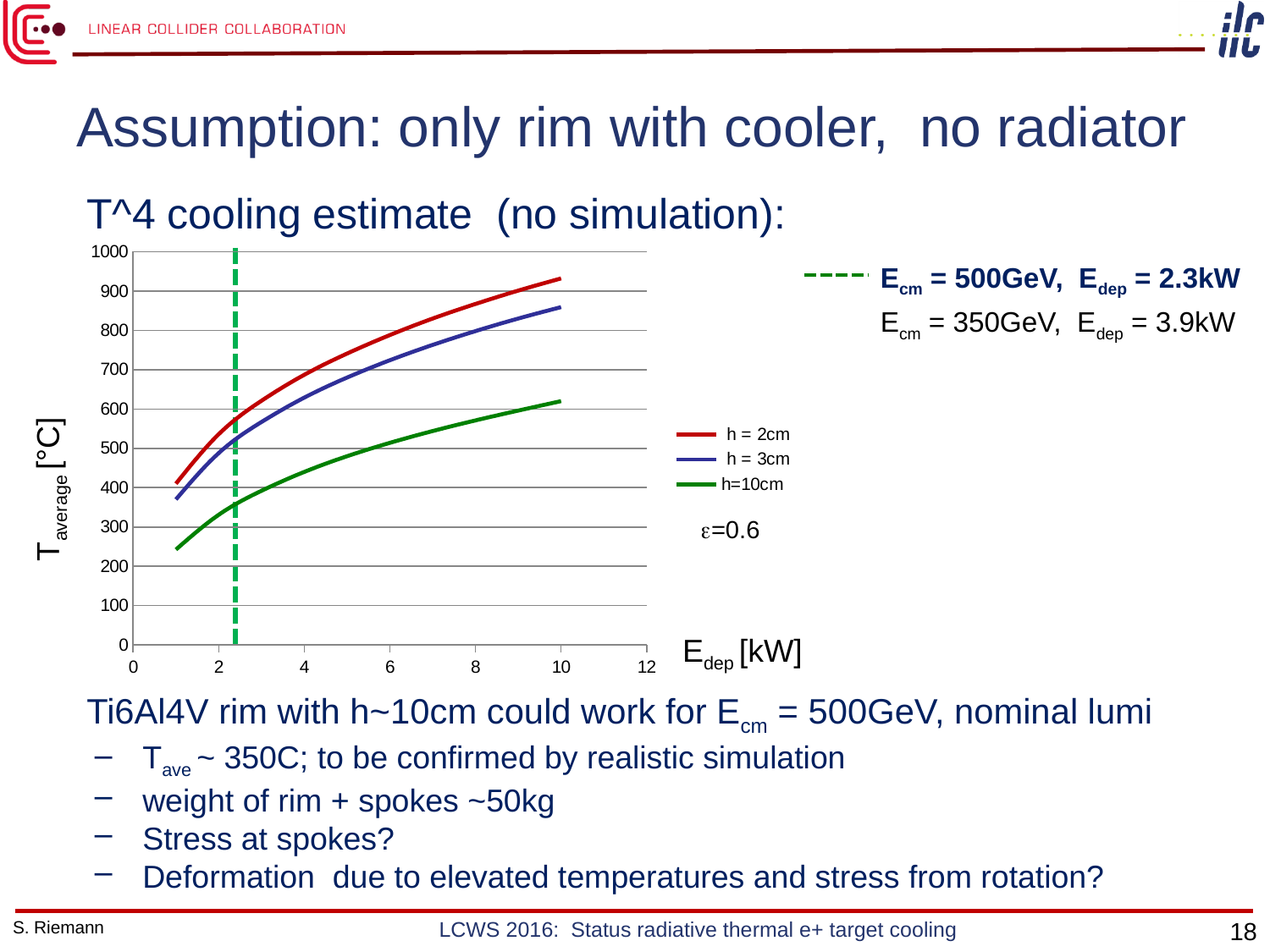
What kind of chart is shown on the slide? line chart What is the label of the y axis of the chart? T_average [°C] Is the value of the h=10cm curve at E_dep = 1 kW greater or less than 300? less At E_dep = 6 kW, which curve is higher: h = 2cm or h=10cm? h = 2cm Does T_average rise or fall as E_dep increases for the h = 3cm series? rise How many series does the chart legend list? 3 What is the highest tick value shown on the x axis (E_dep [kW])? 12 Which series has the highest T_average across the plotted range of E_dep? h = 2cm Which series has the lowest T_average across the plotted range of E_dep? h=10cm Is the value of the h = 3cm curve at E_dep = 10 kW greater or less than 800? greater Is the value of the h = 2cm curve at E_dep = 10 kW greater or less than 900? greater